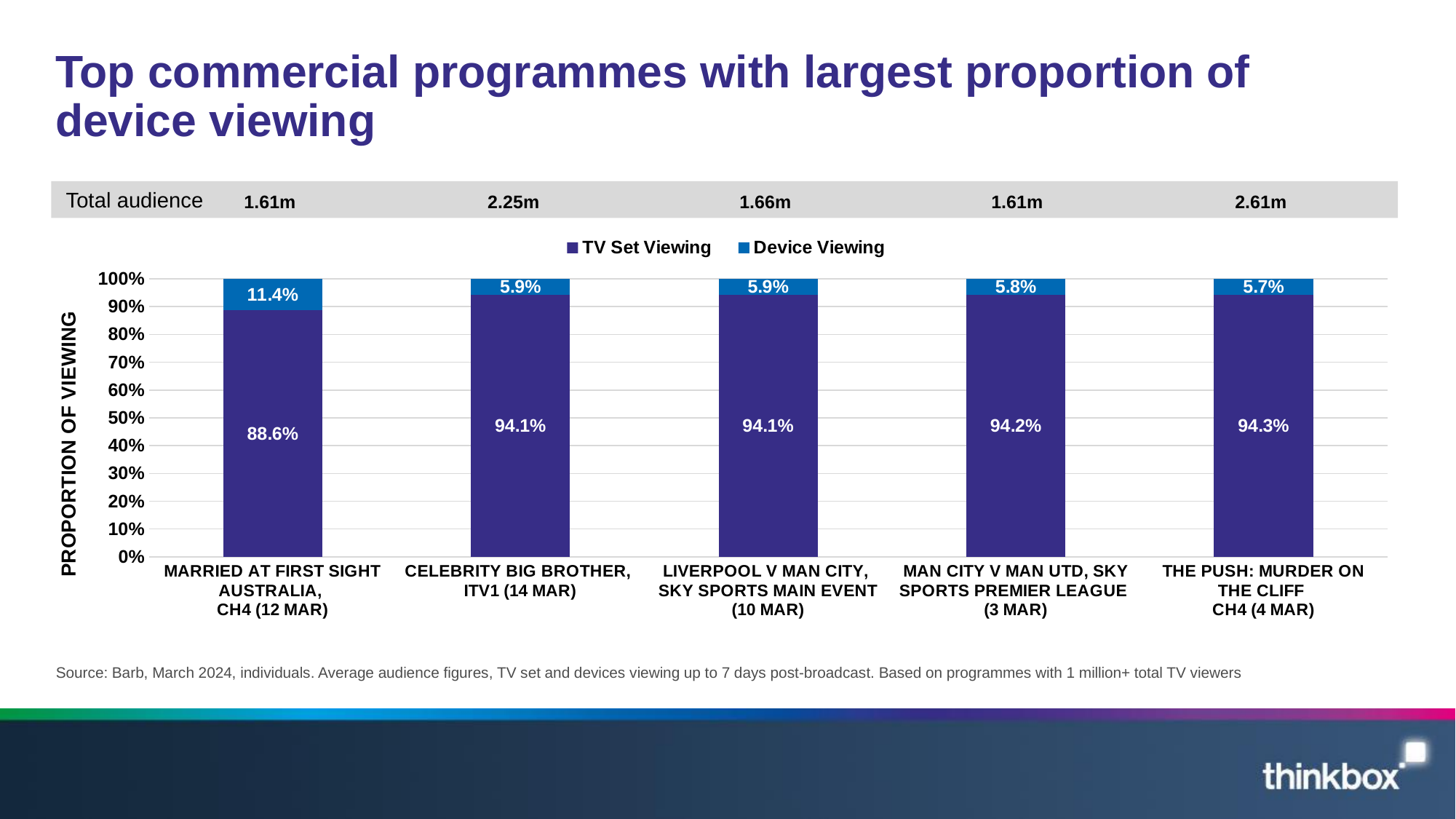
What is the total audience shown for The Push: Murder on the Cliff, CH4 (4 Mar)? 2.61m What is the Device Viewing value for Man City v Man Utd, Sky Sports Premier League (3 Mar)? 5.8% What is the difference between the Device Viewing values for Married at First Sight Australia and Celebrity Big Brother? 5.5% What is the TV Set Viewing value for The Push: Murder on the Cliff, CH4 (4 Mar)? 94.3% What is the Device Viewing value for Married at First Sight Australia, CH4 (12 Mar)? 11.4% Which is larger: the TV Set Viewing value for Married at First Sight Australia or for Liverpool v Man City? Liverpool v Man City How many series does the legend list? 2 What kind of chart is shown on the slide? Stacked bar chart How many programmes are shown on the chart? 5 Which programme has the lowest TV Set Viewing proportion? Married at First Sight Australia, CH4 (12 Mar) Is the TV Set Viewing value for Celebrity Big Brother, ITV1 (14 Mar) greater or less than 90%? greater Which programme has the highest Device Viewing proportion? Married at First Sight Australia, CH4 (12 Mar)